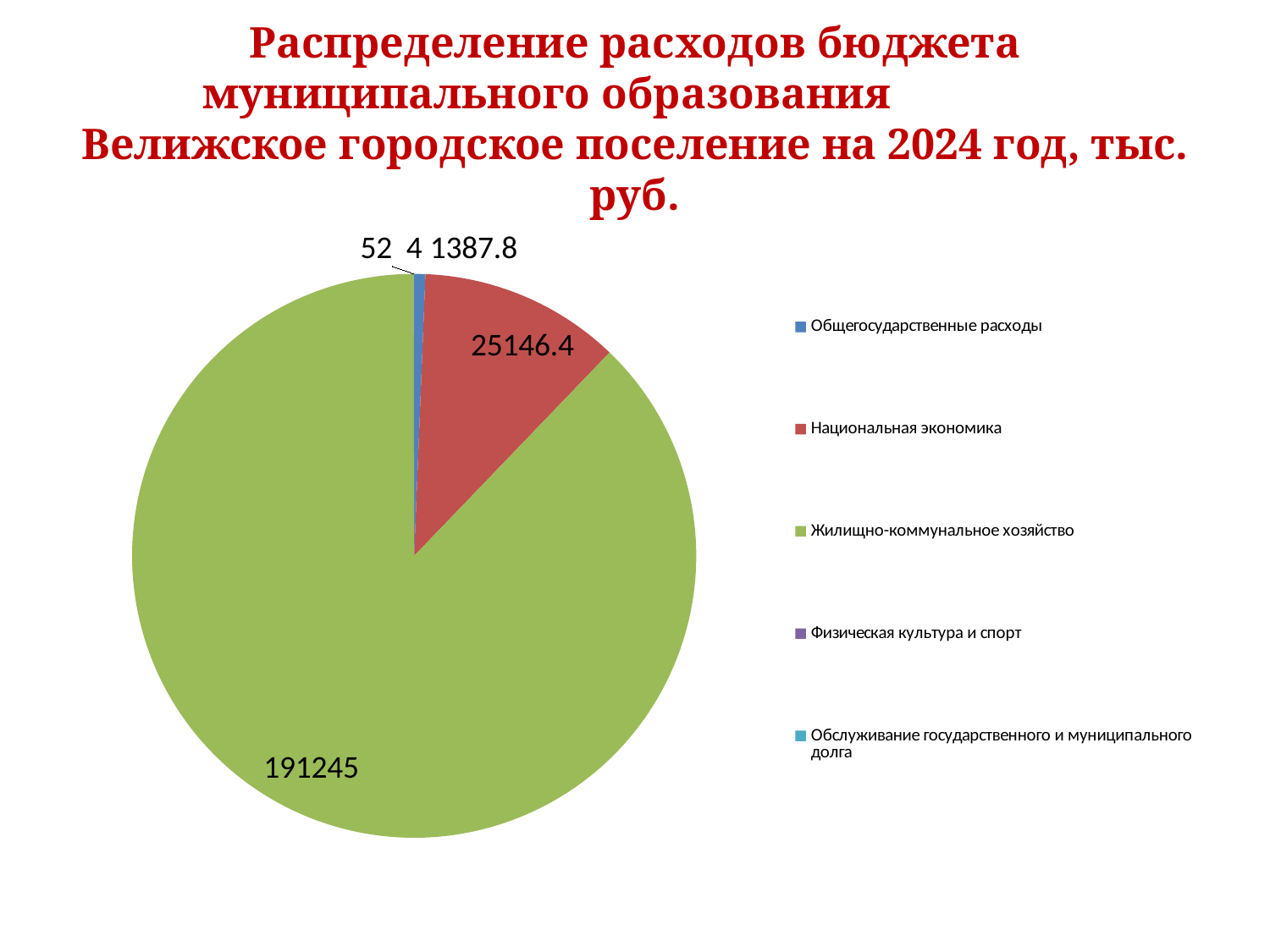
What year does the chart title refer to? 2024 What is the value for Национальная экономика? 25146.4 What colour is the slice for Жилищно-коммунальное хозяйство? Green How many categories does the legend list? 5 What share of the total does Жилищно-коммунальное хозяйство represent? 87.8% What is the value for Жилищно-коммунальное хозяйство? 191245 Which category has the largest share of the pie? Жилищно-коммунальное хозяйство How many slices does the pie chart have? 5 Which is larger, Жилищно-коммунальное хозяйство or Национальная экономика? Жилищно-коммунальное хозяйство What kind of chart is shown on the slide? Pie chart What is the difference between the values for Жилищно-коммунальное хозяйство and Национальная экономика? 166098.6